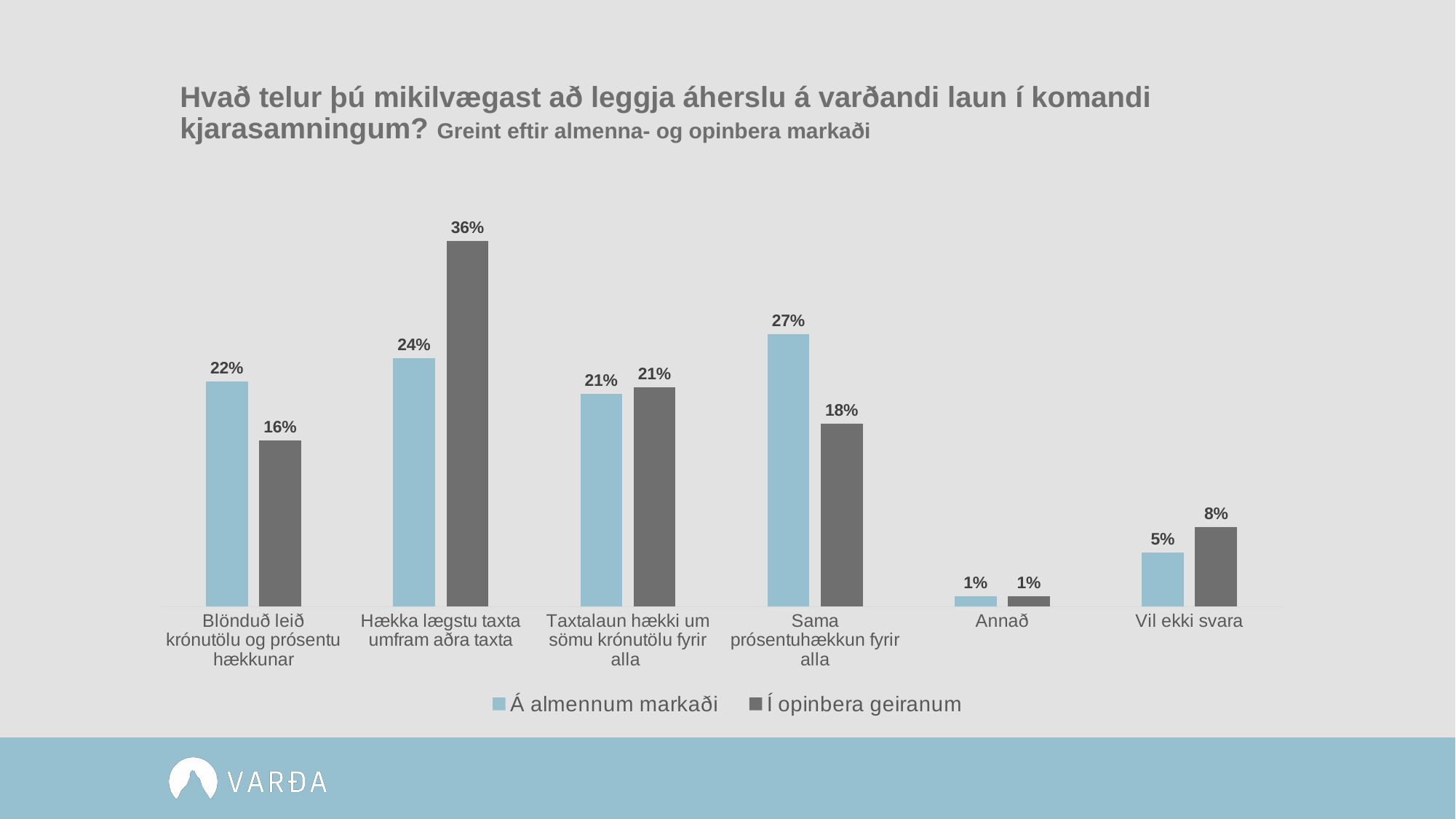
Which category has the highest value for "Í opinbera geiranum"? Hækka lægstu taxta umfram aðra taxta Which series has the larger value for "Blönduð leið krónutölu og prósentu hækkunar"? Á almennum markaði What is the difference between the "Í opinbera geiranum" and "Á almennum markaði" values for "Hækka lægstu taxta umfram aðra taxta"? 12% What is the value for "Í opinbera geiranum" in the category "Sama prósentuhækkun fyrir alla"? 18% What is the value for "Í opinbera geiranum" in the category "Hækka lægstu taxta umfram aðra taxta"? 36% Which category has the lowest value for "Á almennum markaði"? Annað Which category has the highest value for "Á almennum markaði"? Sama prósentuhækkun fyrir alla How many categories are shown on the x axis? 6 What is the value for "Á almennum markaði" in the category "Vil ekki svara"? 5% What kind of chart is shown on the slide? Bar chart How many series does the legend list? 2 What is the value for "Á almennum markaði" in the category "Blönduð leið krónutölu og prósentu hækkunar"? 22%